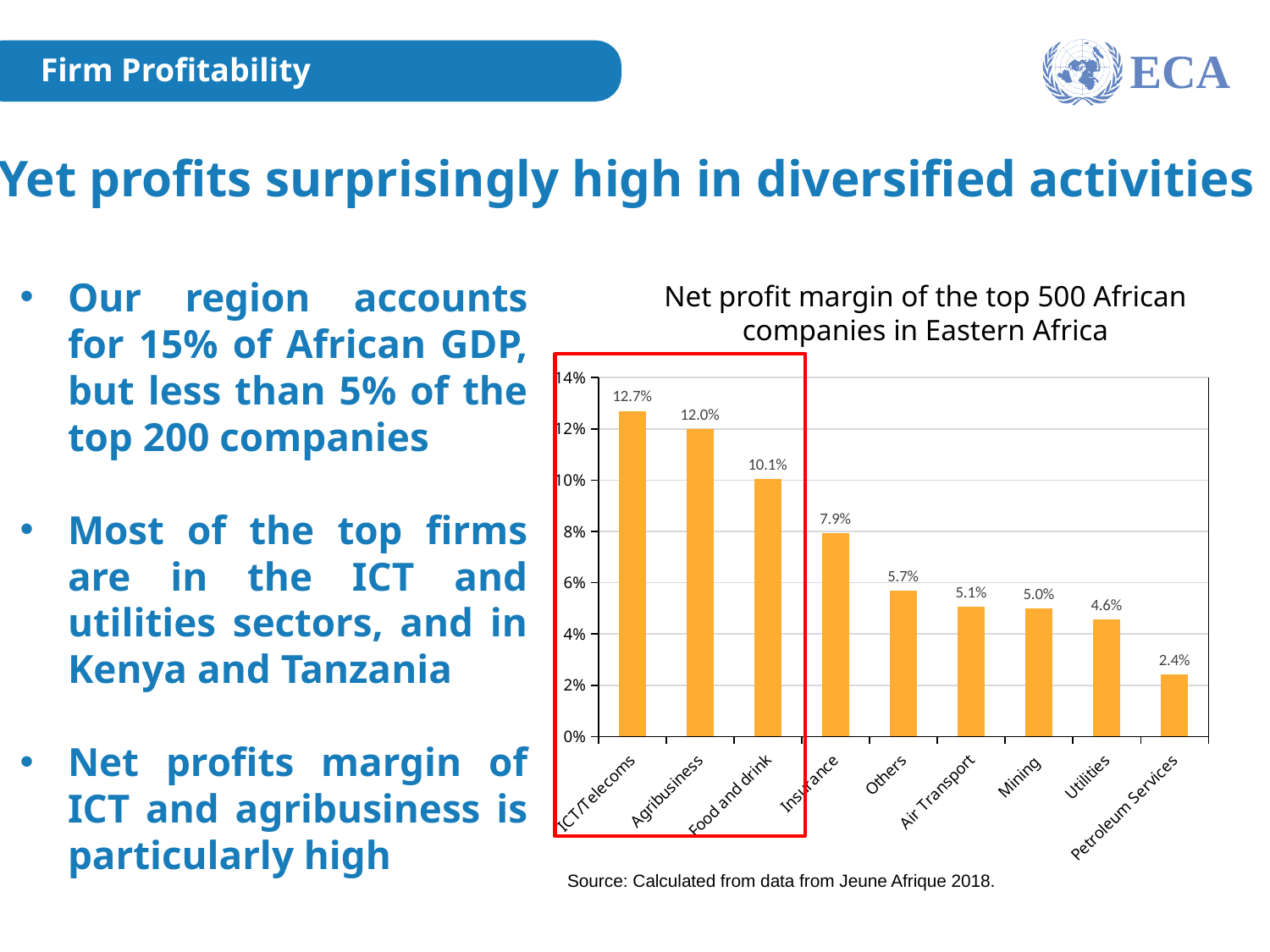
What is the net profit margin for ICT/Telecoms? 12.7% What is the net profit margin for Insurance? 7.9% What is the title of the chart? Net profit margin of the top 500 African companies in Eastern Africa Do the values rise or fall from left to right along the x axis? Fall What kind of chart is shown on the slide? Bar chart How many categories are shown on the chart? 9 Is the value for Others greater or less than 6%? less What is the net profit margin for Petroleum Services? 2.4% Which category has the highest net profit margin? ICT/Telecoms Which category has the lowest net profit margin? Petroleum Services Which has a higher net profit margin, Mining or Utilities? Mining What is the difference between the net profit margins of Agribusiness and Food and drink? 1.9%